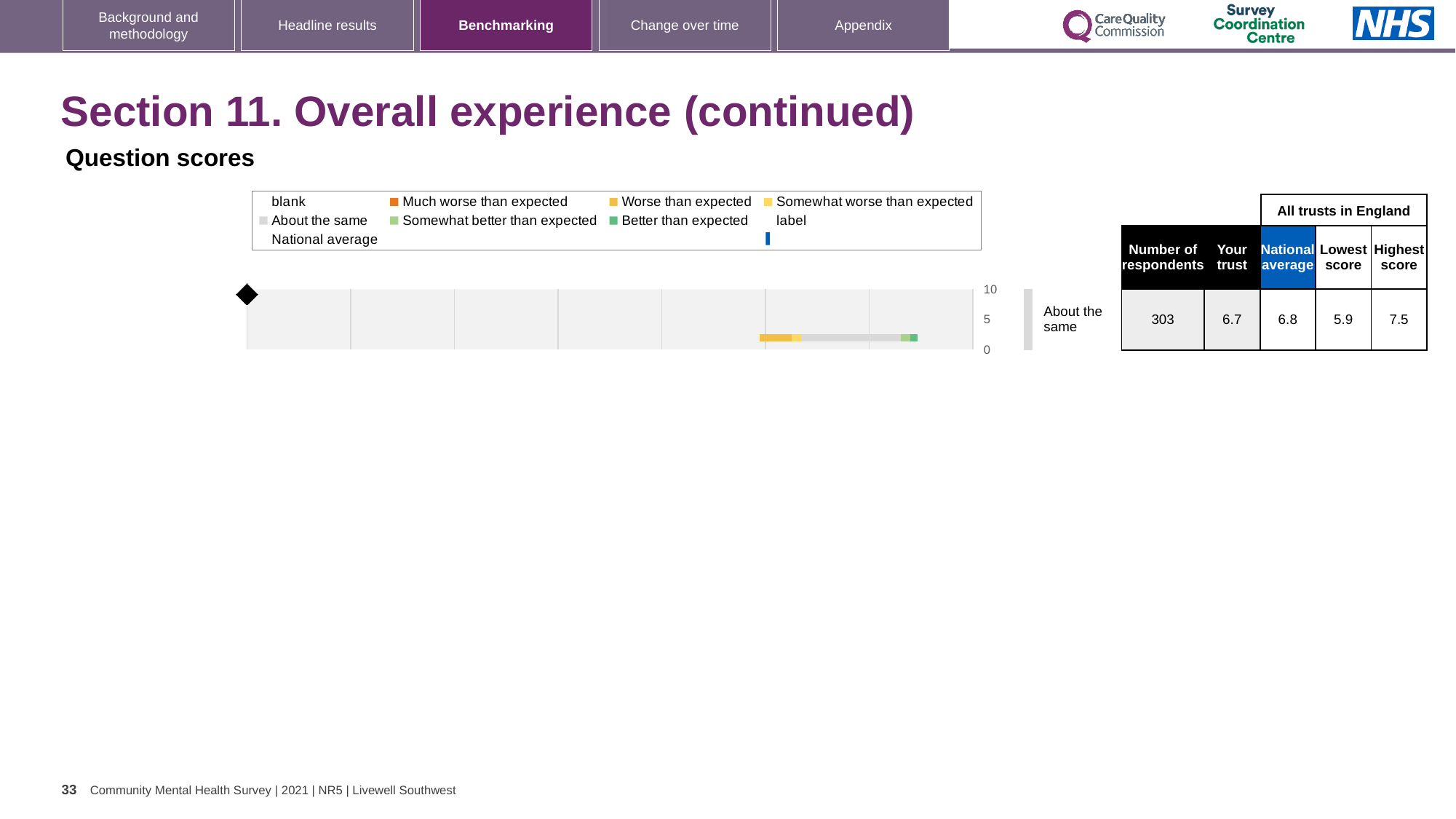
What is the difference between the highest score and the lowest score for this question? 1.6 Which is larger for this question: the 'Your trust' score or the national average? National average What kind of chart is shown on the slide? bar chart What is the highest score among all trusts in England for this question? 7.5 What is the lowest score among all trusts in England for this question? 5.9 How many respondents are listed for the question shown in the chart? 303 What is the national average score shown for the question in the chart? 6.8 How many question rows are plotted in the chart? 1 What is the 'Your trust' score for the question shown in the chart? 6.7 Is the 'Your trust' score greater or less than 5? greater By how much does the national average exceed the 'Your trust' score? 0.1 What benchmark category is the trust's result for this question labelled as? About the same